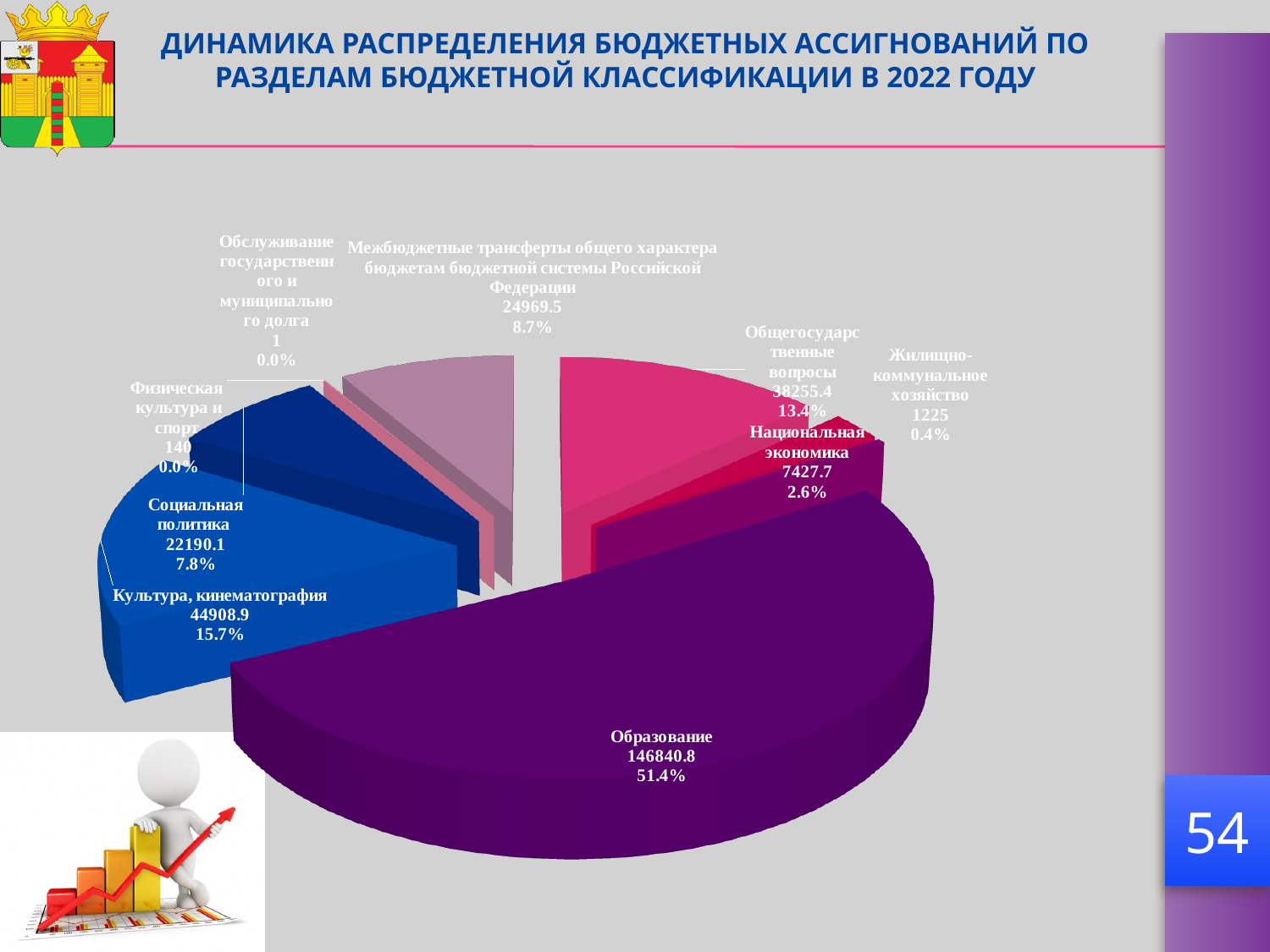
What kind of chart is shown on the slide? pie chart What share of the pie does Общегосударственные вопросы represent? 13.4% What is the value shown for Социальная политика? 22190.1 What is the value shown for Образование? 146840.8 What is the value shown for Национальная экономика? 7427.7 What is the difference between the values for Образование and Культура, кинематография? 101931.9 How many categories (slices) does the pie chart show? 9 Which category has the smallest value in the pie chart? Обслуживание государственного и муниципального долга Which is larger: the value for Общегосударственные вопросы or the value for Социальная политика? Общегосударственные вопросы Which category has the largest value in the pie chart? Образование What share of the pie does Образование represent? 51.4% What is the value shown for Культура, кинематография? 44908.9